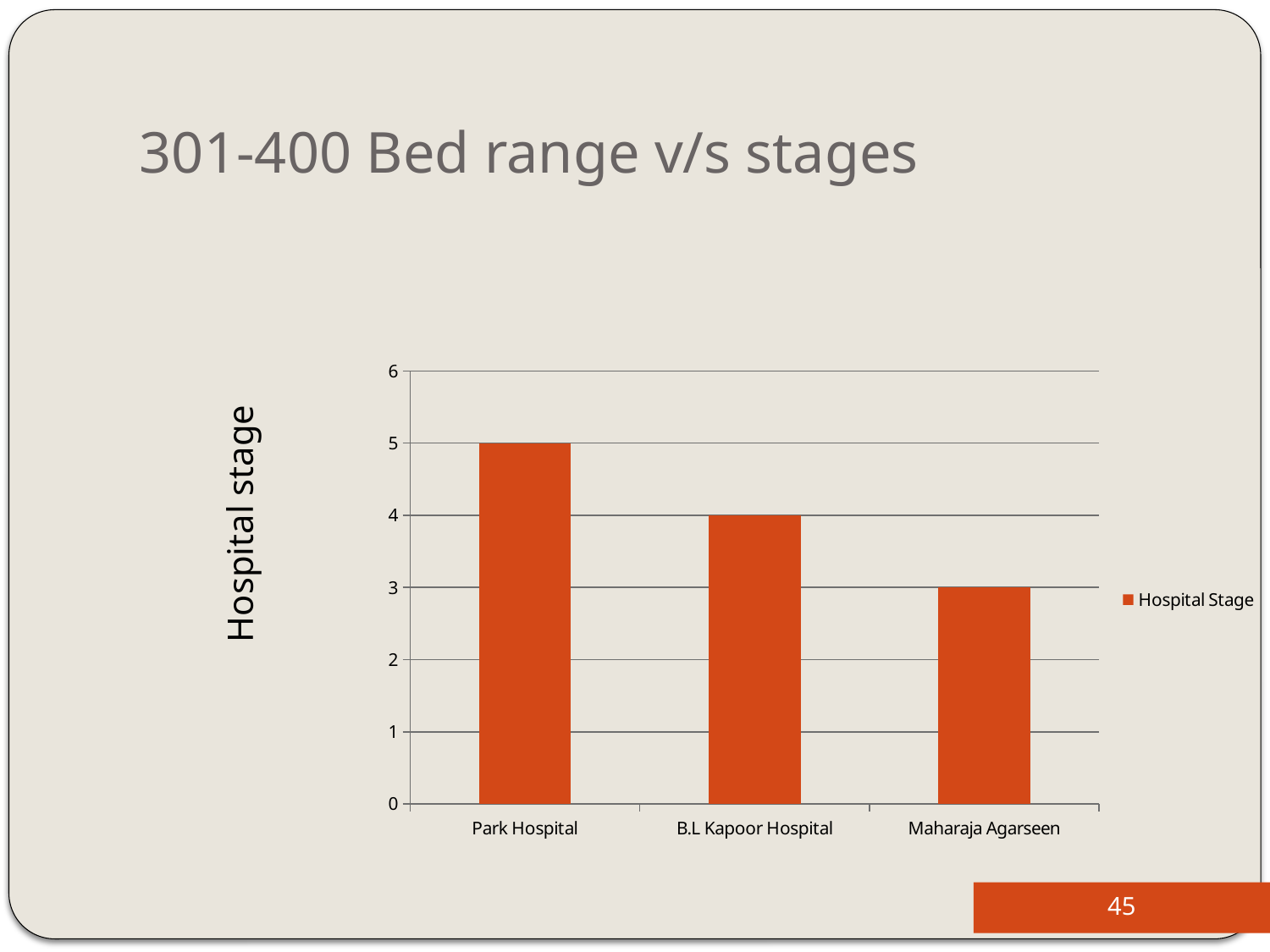
What is the hospital stage for Maharaja Agarseen? 3 Which has a higher hospital stage, B.L Kapoor Hospital or Maharaja Agarseen? B.L Kapoor Hospital Which hospital has the lowest hospital stage? Maharaja Agarseen Which hospital has the highest hospital stage? Park Hospital How many series does the legend list? 1 What is the hospital stage for Park Hospital? 5 Is the value for Park Hospital greater or less than 4? greater What is the hospital stage for B.L Kapoor Hospital? 4 How many hospitals are shown on the chart? 3 What is the difference in hospital stage between Park Hospital and Maharaja Agarseen? 2 Do the values rise or fall from left to right across the hospitals? fall What kind of chart is shown on the slide? bar chart